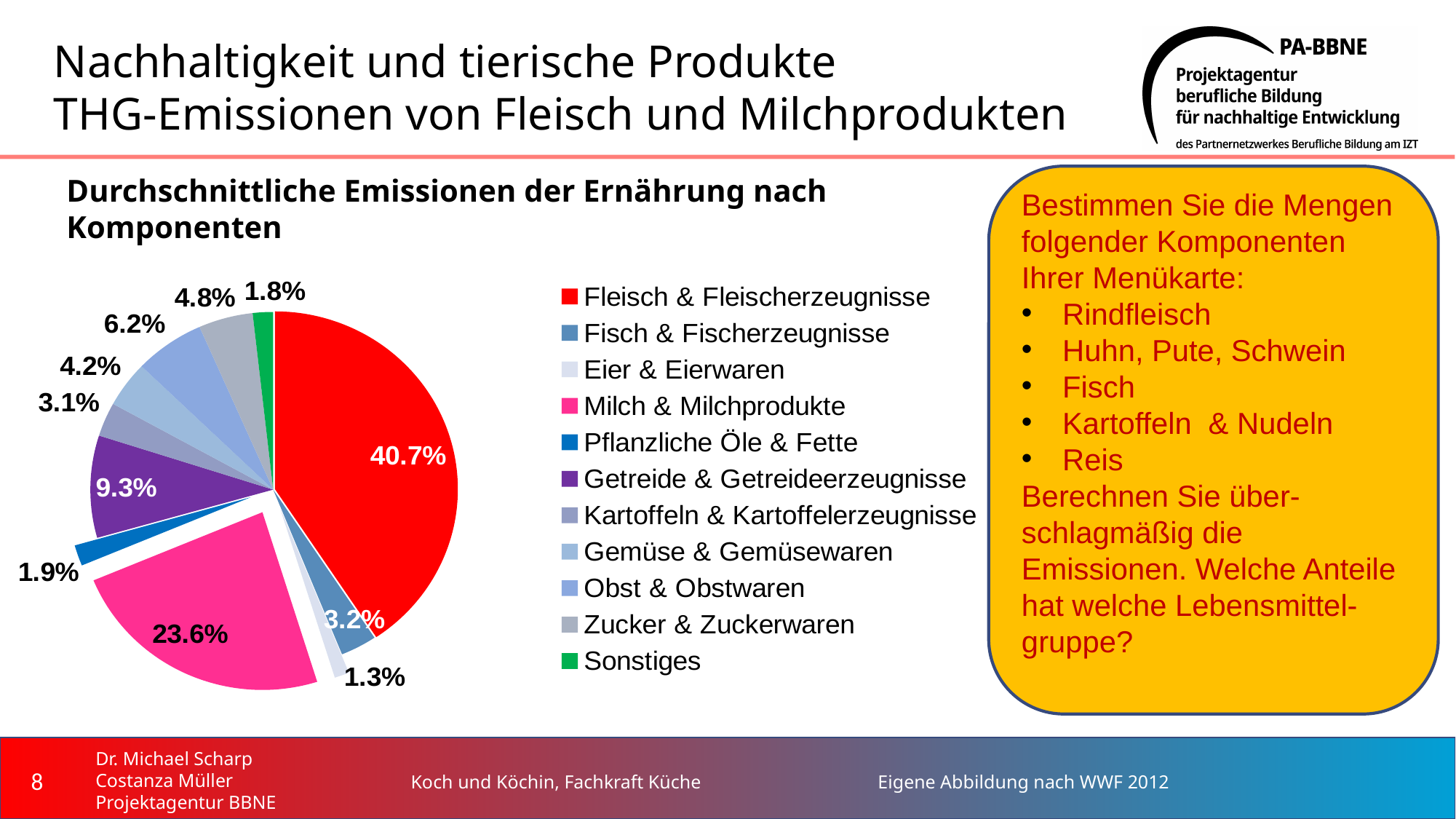
How many components are listed in the legend of the pie chart? 11 What share of emissions does Sonstiges account for? 1.8% How many percentage points larger is the share of Fleisch & Fleischerzeugnisse than that of Milch & Milchprodukte? 17.1 percentage points What kind of chart is shown on the slide? pie chart What share of emissions does Fleisch & Fleischerzeugnisse account for? 40.7% Which component has the largest share of emissions? Fleisch & Fleischerzeugnisse What share of emissions does Milch & Milchprodukte account for? 23.6% What share of emissions does Fisch & Fischerzeugnisse account for? 3.2% What is the title of the pie chart? Durchschnittliche Emissionen der Ernährung nach Komponenten What share of emissions does Getreide & Getreideerzeugnisse account for? 9.3% Which component has the smallest share of emissions? Eier & Eierwaren Which has a larger share: Obst & Obstwaren or Zucker & Zuckerwaren? Obst & Obstwaren